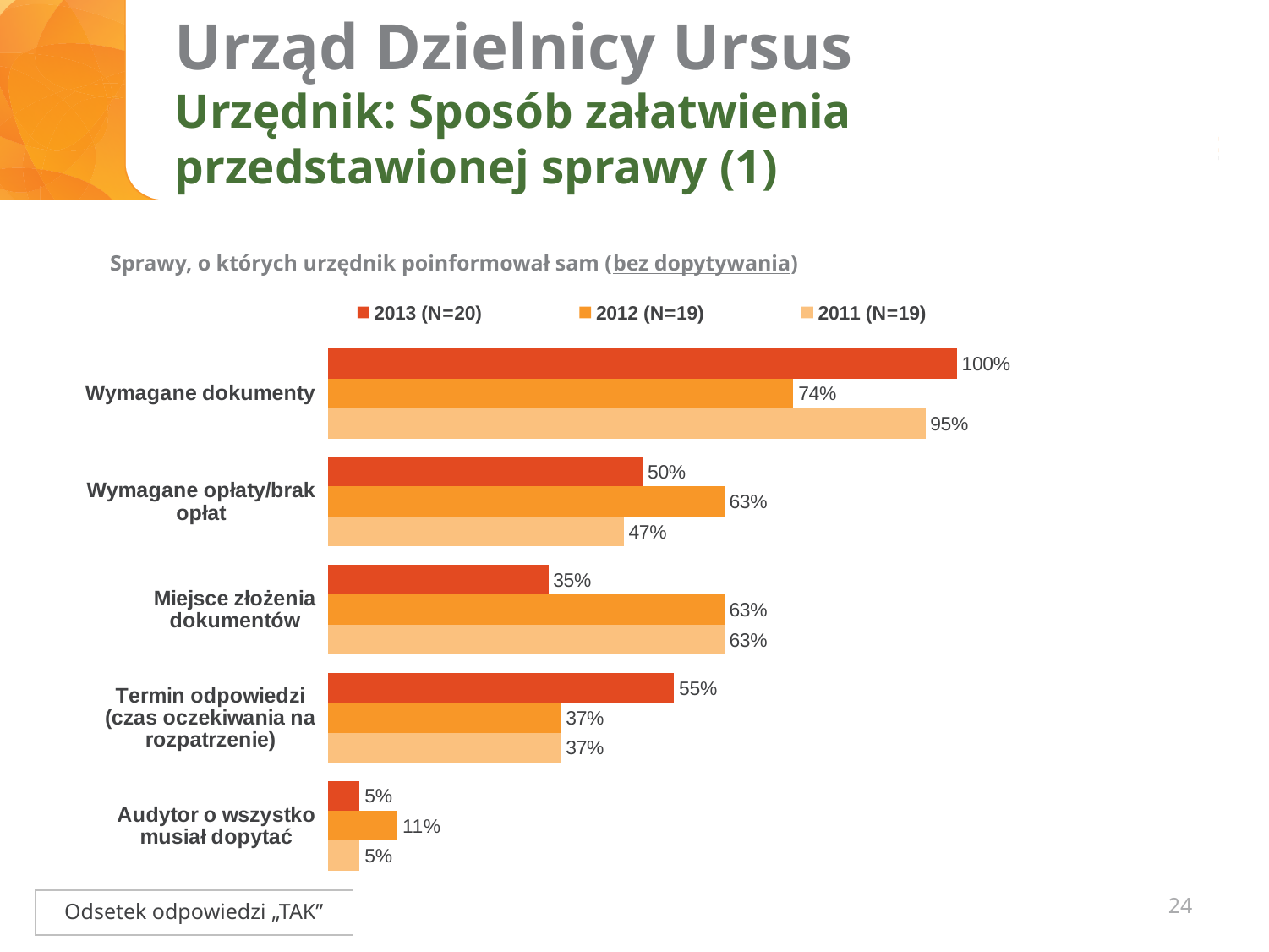
How many categories are shown on the chart? 5 What is the value for "Wymagane opłaty/brak opłat" in the 2012 (N=19) series? 63% For "Miejsce złożenia dokumentów", which is larger: the 2013 (N=20) value or the 2012 (N=19) value? 2012 (N=19) Which category has the highest value in the 2013 (N=20) series? Wymagane dokumenty What is the value for "Wymagane dokumenty" in the 2013 (N=20) series? 100% What kind of chart is shown on the slide? Bar chart What is the value for "Termin odpowiedzi (czas oczekiwania na rozpatrzenie)" in the 2011 (N=19) series? 37% What is the title of the chart? Sprawy, o których urzędnik poinformował sam (bez dopytywania) How many series does the legend list? 3 Which category has the lowest value in the 2012 (N=19) series? Audytor o wszystko musiał dopytać What is the difference between the 2013 (N=20) and 2012 (N=19) values for "Wymagane dokumenty"? 26% What is the value for "Audytor o wszystko musiał dopytać" in the 2012 (N=19) series? 11%